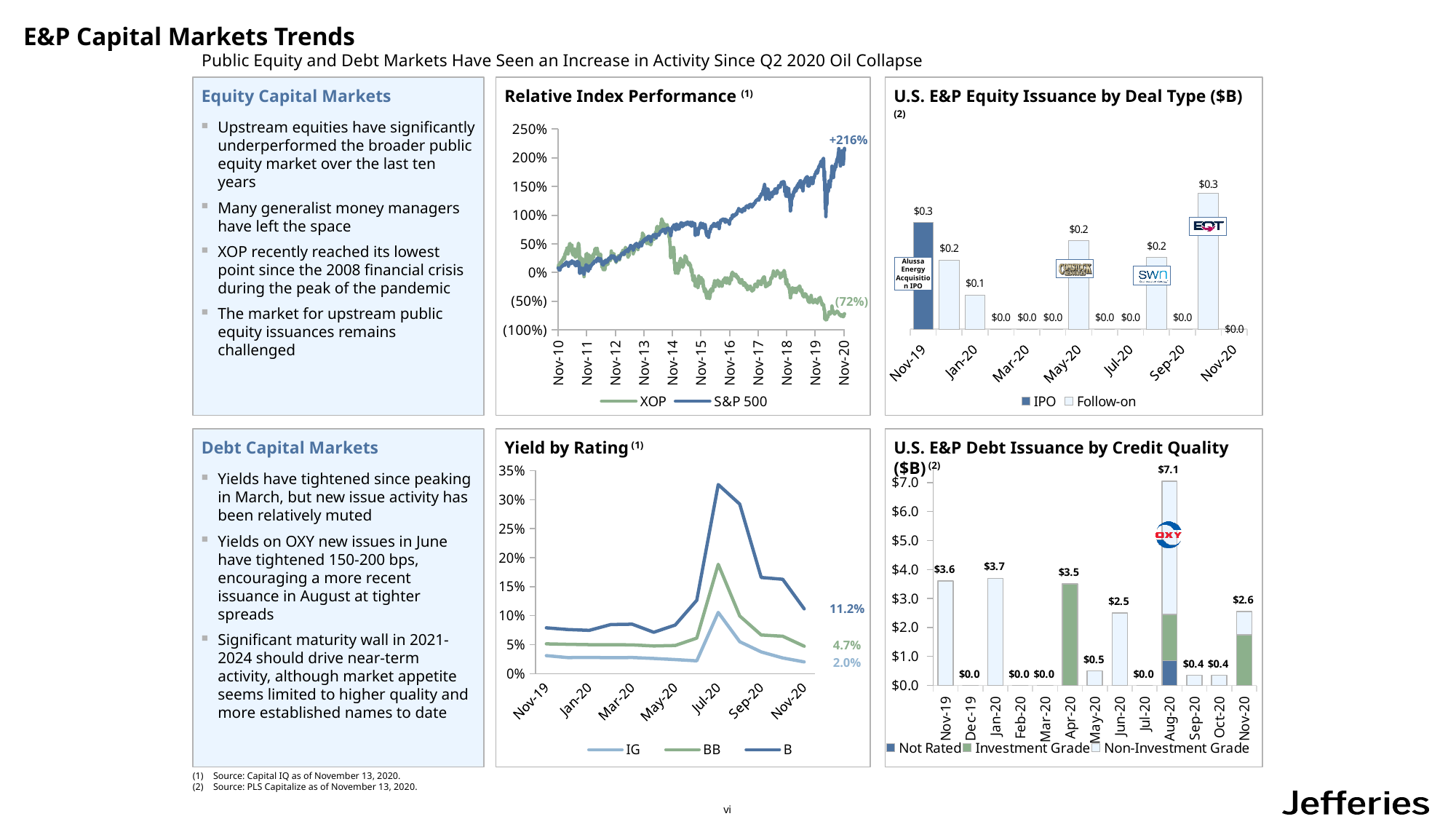
In the Relative Index Performance chart, what value is labelled at the end of the S&P 500 line in Nov-20? +216% In the U.S. E&P Debt Issuance by Credit Quality chart, what is the difference between the Aug-20 total and the Nov-19 total? $3.5 In the U.S. E&P Debt Issuance by Credit Quality chart, what is the total issuance labelled for Jan-20? $3.7 In the Yield by Rating chart, which rating series has the highest yield at Nov-20? B In the Yield by Rating chart, what is the value labelled at the end of the B line in Nov-20? 11.2% What kind of chart is the Relative Index Performance chart? line chart In the Relative Index Performance chart, what value is labelled at the end of the XOP line in Nov-20? (72%) In the U.S. E&P Equity Issuance by Deal Type chart, what is the value of the IPO bar in Nov-19? $0.3 In the U.S. E&P Debt Issuance by Credit Quality chart, which month has the highest total issuance? Aug-20 How many series does the legend of the Yield by Rating chart list? 3 In the Yield by Rating chart, what is the value labelled at the end of the IG line in Nov-20? 2.0% In the Relative Index Performance chart, does the XOP line rise or fall overall from Nov-10 to Nov-20? fall